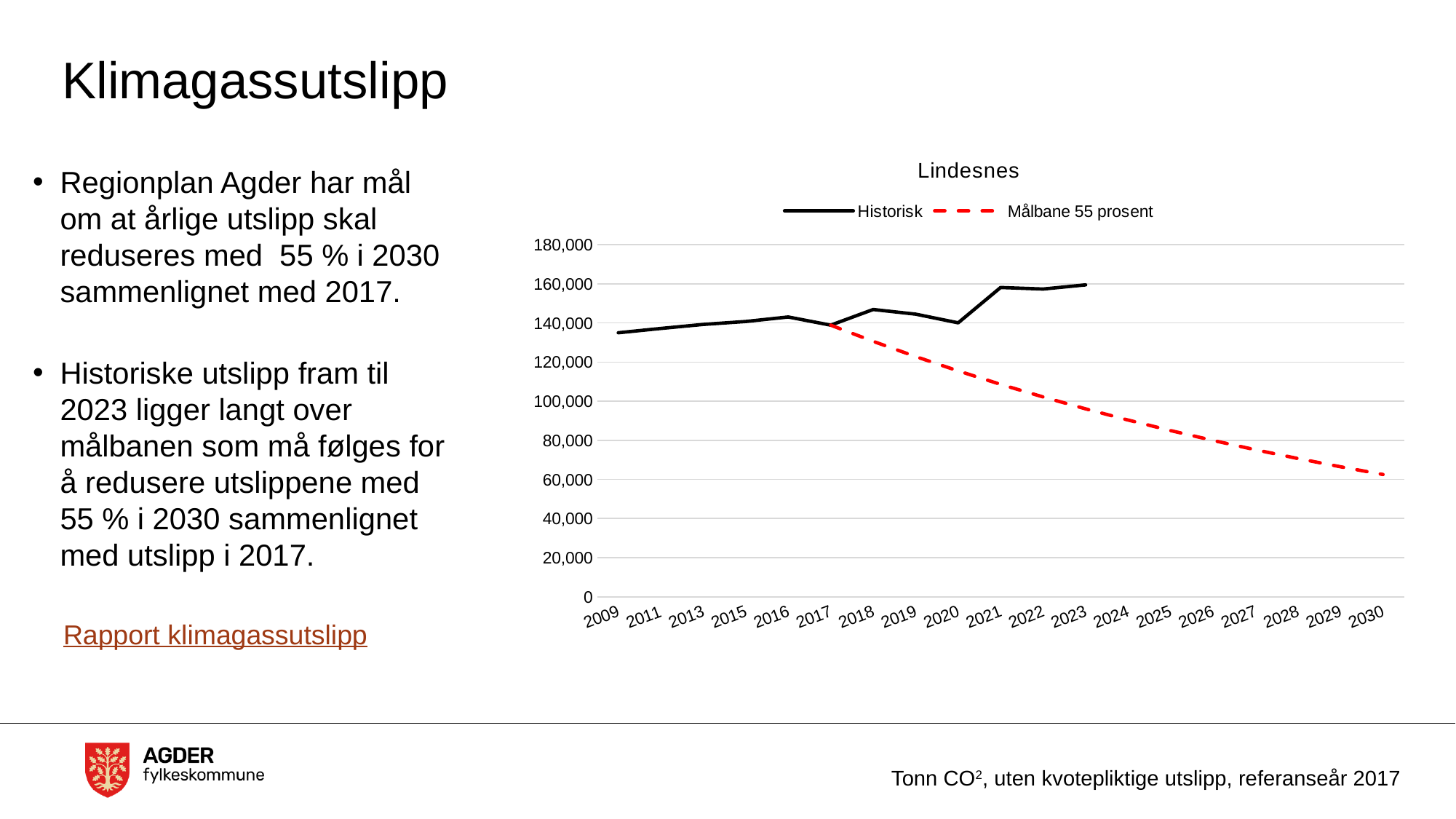
What is the title of the chart? Lindesnes In 2023, which is larger: the Historisk value or the Målbane 55 prosent value? Historisk Is the Historisk value for 2009 greater or less than 140,000? less Is the Målbane 55 prosent value for 2025 greater or less than 100,000? less Is the Historisk value for 2021 greater or less than 140,000? greater How many years are labelled along the x axis? 19 Does the Målbane 55 prosent line rise or fall from 2017 to 2030? Falls Which is larger for the Historisk series: the value for 2020 or the value for 2021? 2021 What kind of chart is shown on the slide? Line chart How many series does the chart legend list? 2 Which series is drawn as a red dashed line? Målbane 55 prosent